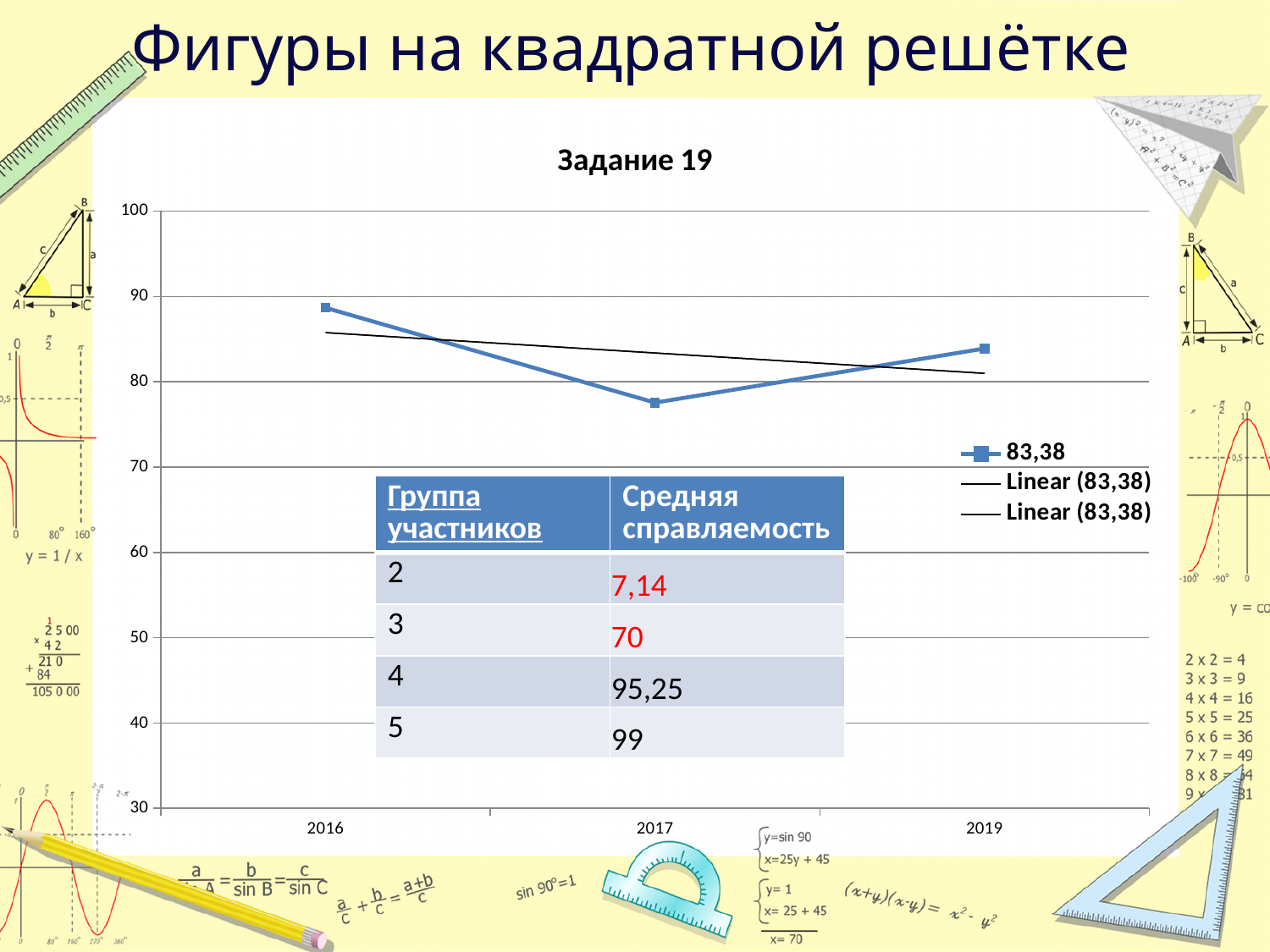
Which year has the lowest value on the plotted line? 2017 Which is larger, the value for 2016 or the value for 2019? 2016 What is the title of the chart? Задание 19 Is the value for 2017 greater or less than 80? less What kind of chart is shown on the slide? line chart Does the plotted line rise or fall from 2016 to 2017? fall What is the name of the first series listed in the legend? 83,38 How many entries does the chart legend list? 3 How many data points are plotted on the line in the chart? 3 Is the value for 2019 greater or less than 90? less Is the value for 2016 greater or less than 80? greater Which year has the highest value on the plotted line? 2016